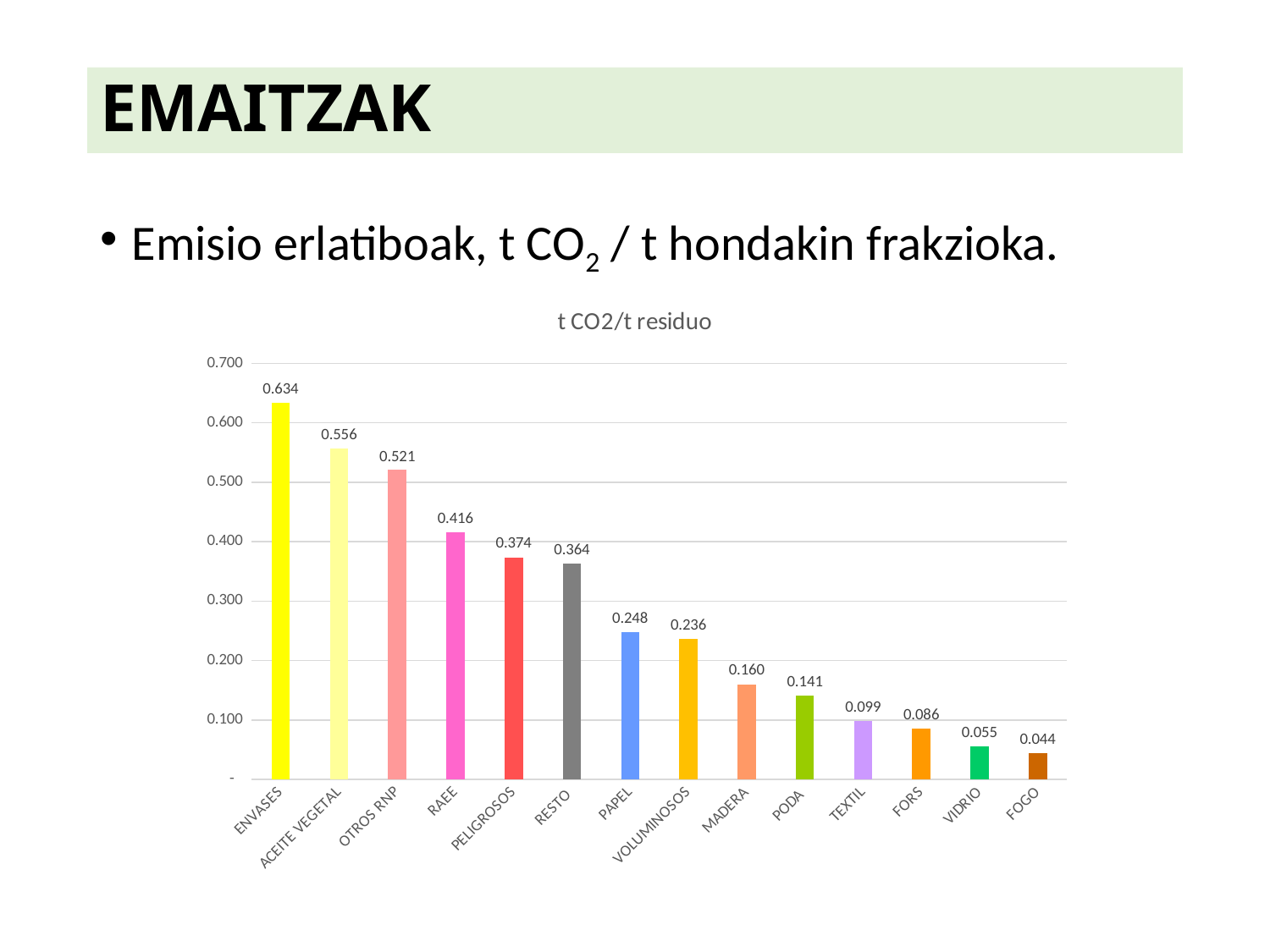
What is the difference between the values for MADERA and PODA? 0.019 What is the value for ENVASES? 0.634 Which category has the lowest value? FOGO Which is larger, the value for RAEE or the value for RESTO? RAEE What is the value for PAPEL? 0.248 How many categories are shown in the chart? 14 What is the title of the chart? t CO2/t residuo Is the value for OTROS RNP greater or less than 0.500? greater What kind of chart is shown on the slide? Bar chart Which category has the highest value? ENVASES What is the difference between the values for ENVASES and ACEITE VEGETAL? 0.078 What is the value for VIDRIO? 0.055